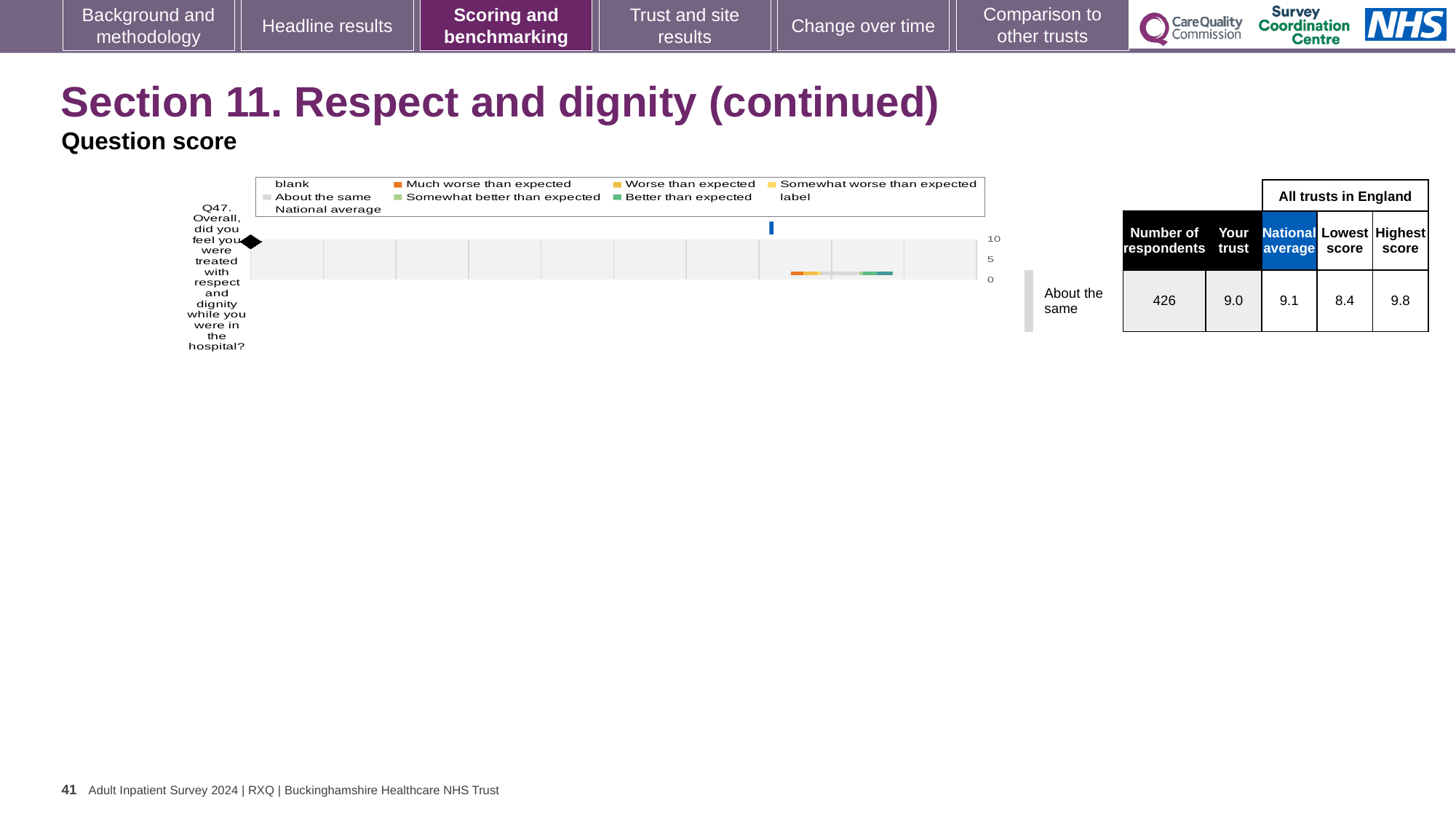
How many respondents are listed for Q47? 426 What kind of chart is shown on the slide? bar chart What is the difference between the highest score and the lowest score for Q47? 1.4 What is the lowest score among all trusts in England for Q47? 8.4 How many questions (categories) are plotted on the chart? 1 What benchmark category is shown for Q47 next to the chart? About the same What is the 'Your trust' score for Q47 in the table beside the chart? 9.0 For Q47, which is larger: the 'Your trust' score or the national average? National average What is the highest score among all trusts in England for Q47? 9.8 What is the national average score for Q47 in the table beside the chart? 9.1 Which question number is plotted on the chart? Q47 What is the difference between the national average and the 'Your trust' score for Q47? 0.1